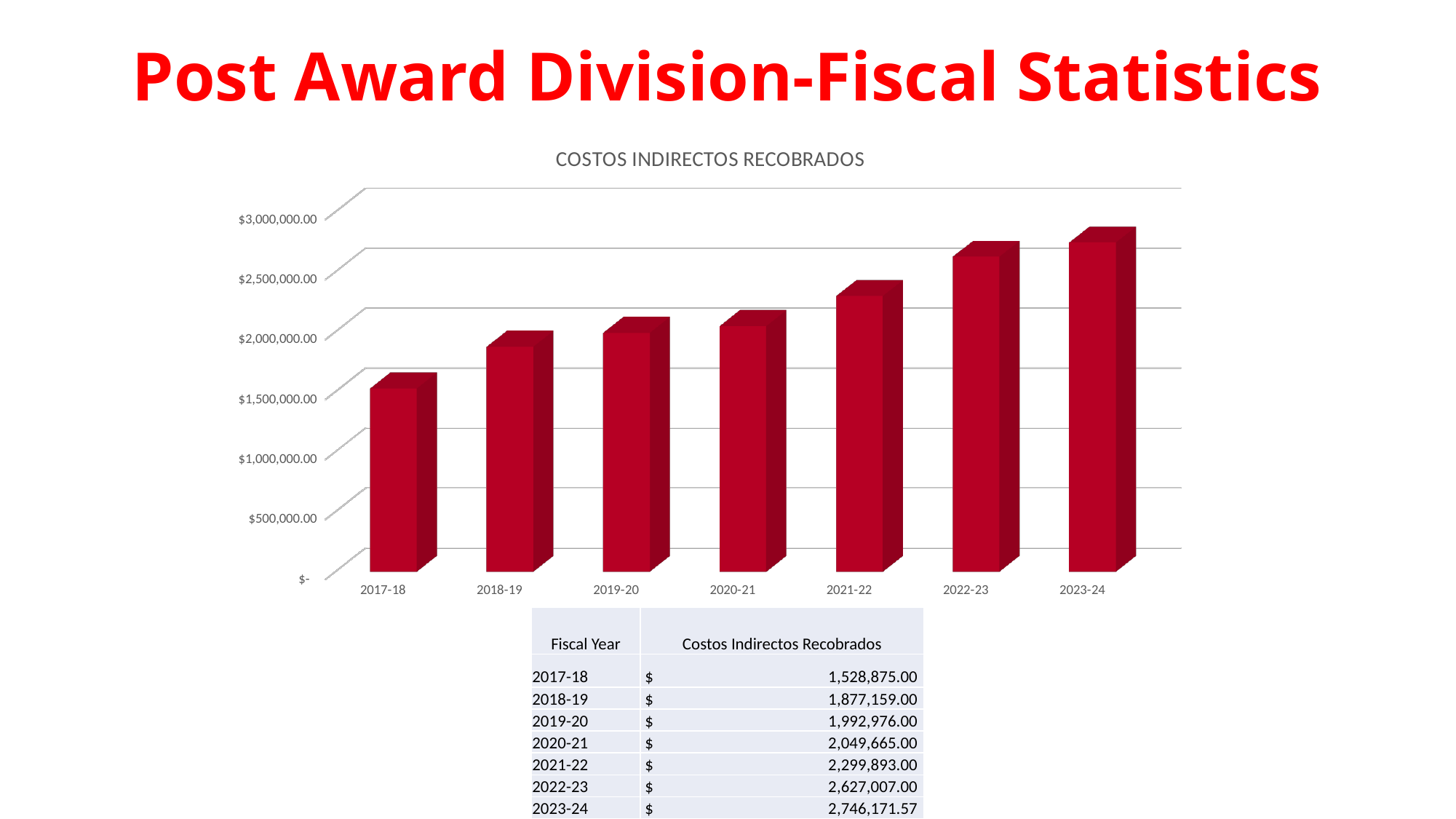
What is the difference between the Costos Indirectos Recobrados for 2022-23 and 2021-22? $327,114.00 Do the Costos Indirectos Recobrados values rise or fall from 2017-18 to 2023-24? Rise Which fiscal year has the lowest Costos Indirectos Recobrados? 2017-18 What is the title of the chart? COSTOS INDIRECTOS RECOBRADOS How many fiscal years are plotted in the chart? 7 Which is larger, the value for 2019-20 or the value for 2022-23? 2022-23 What type of chart is shown on the slide? Bar chart Which fiscal year has the highest Costos Indirectos Recobrados? 2023-24 What is the value of Costos Indirectos Recobrados for 2017-18? $1,528,875.00 What is the difference between the Costos Indirectos Recobrados for 2023-24 and 2017-18? $1,217,296.57 What is the value of Costos Indirectos Recobrados for 2021-22? $2,299,893.00 What is the value of Costos Indirectos Recobrados for 2023-24? $2,746,171.57